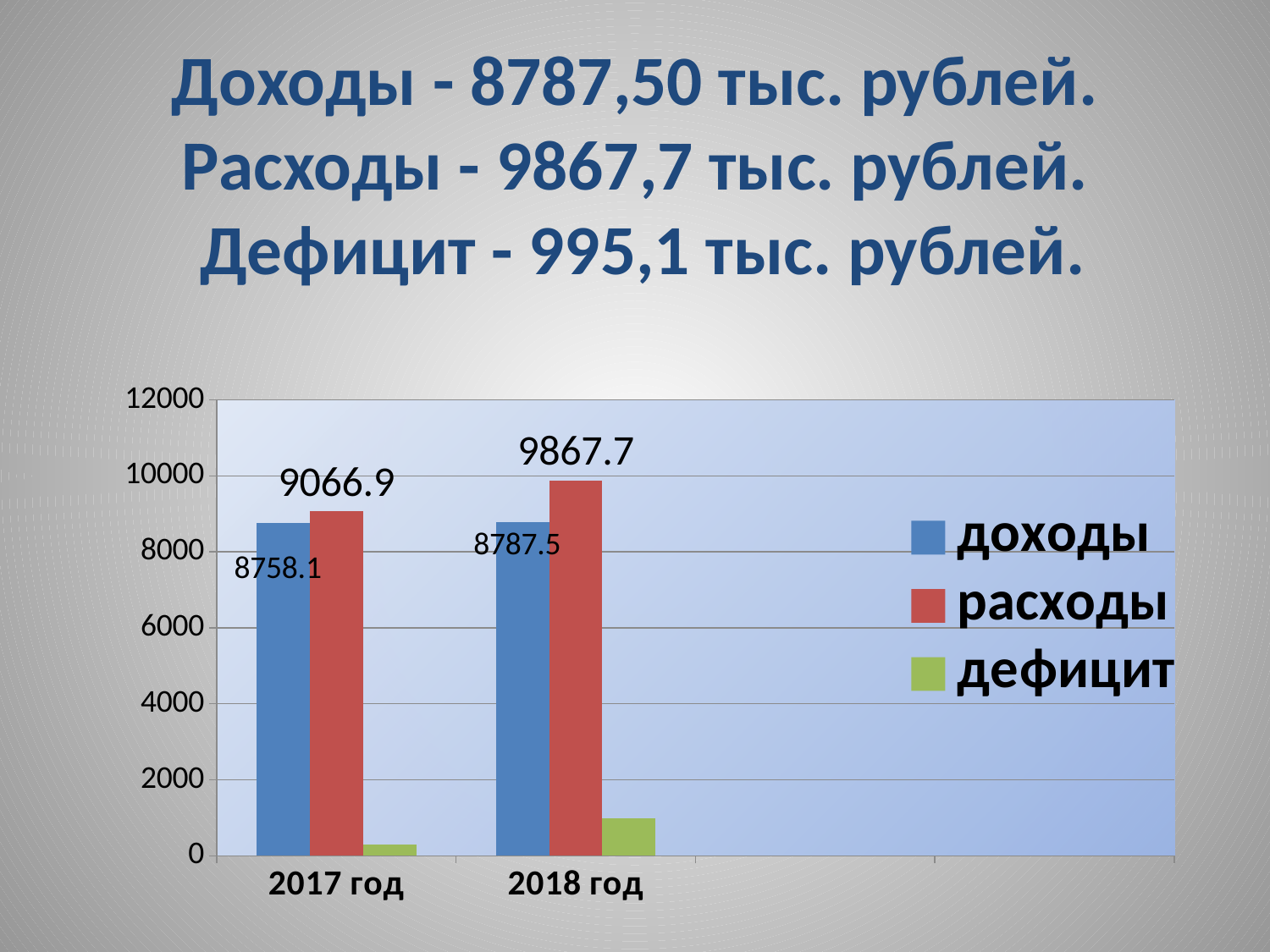
How many categories are shown on the x axis? 2 Do the values for расходы rise or fall from 2017 год to 2018 год? rise By how much do расходы exceed доходы in 2017 год? 308.8 What is the value of расходы for 2017 год? 9066.9 Is the value of дефицит for 2018 год greater or less than 2000? less What is the value of расходы for 2018 год? 9867.7 What is the value of доходы for 2018 год? 8787.5 How many series does the legend list? 3 What kind of chart is shown on the slide? bar chart By how much do расходы exceed доходы in 2018 год? 1080.2 What is the value of доходы for 2017 год? 8758.1 Which year has the larger value for расходы, 2017 год or 2018 год? 2018 год